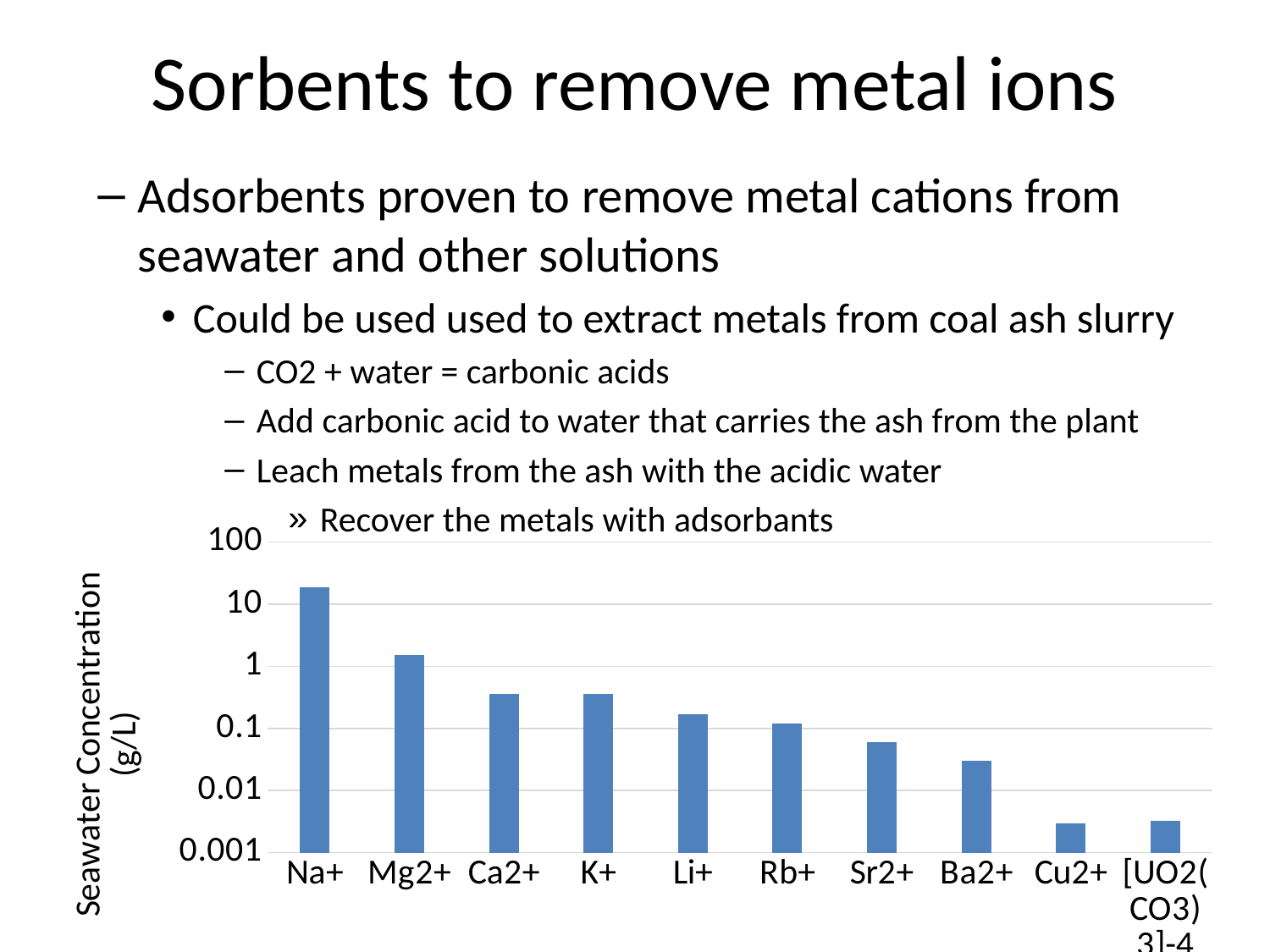
Which ion has the highest seawater concentration in the chart? Na+ How many ions are plotted on the x axis of the chart? 10 Which has the larger seawater concentration, Li+ or Ba2+? Li+ Is the seawater concentration for Ba2+ greater or less than 0.1 g/L? less Do the bar values generally rise or fall from left to right along the x axis? fall Is the seawater concentration for Mg2+ greater or less than 1 g/L? greater Is the seawater concentration for Cu2+ greater or less than 0.01 g/L? less What kind of chart is shown on the slide? bar chart Which has the larger seawater concentration, Na+ or Mg2+? Na+